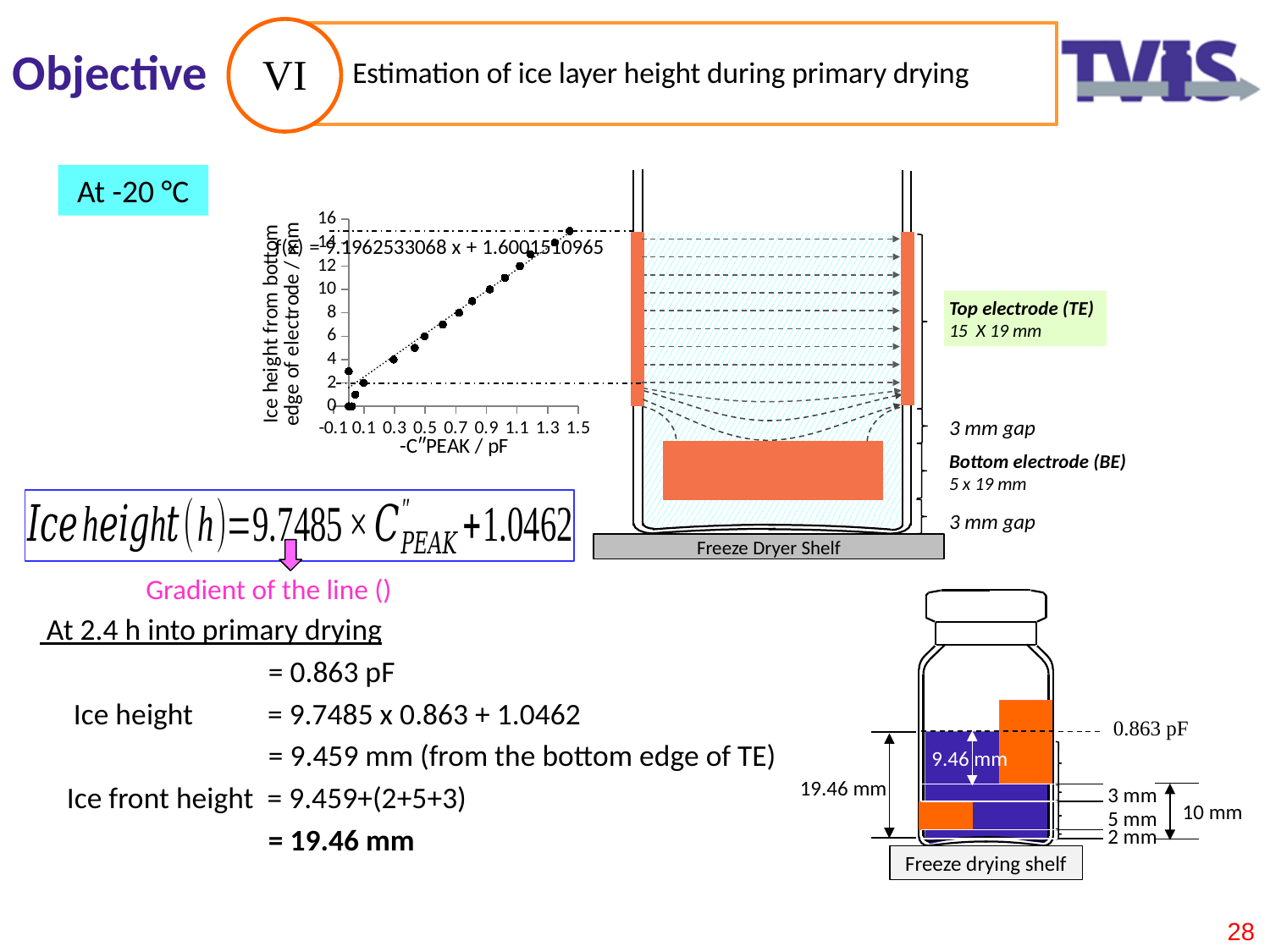
What kind of chart is shown on the slide? scatter chart Do the plotted points rise or fall as the x-axis value (-C″PEAK) increases? rise Is the lowest plotted point on the chart greater or less than 2 mm? less What is the trendline equation printed on the chart? f(x) = 9.1962533068 x + 1.6001510965 What is the label of the x axis of the chart? -C″PEAK / pF What is the highest tick value shown on the y axis of the chart? 16 What is the highest tick value shown on the x axis of the chart? 1.5